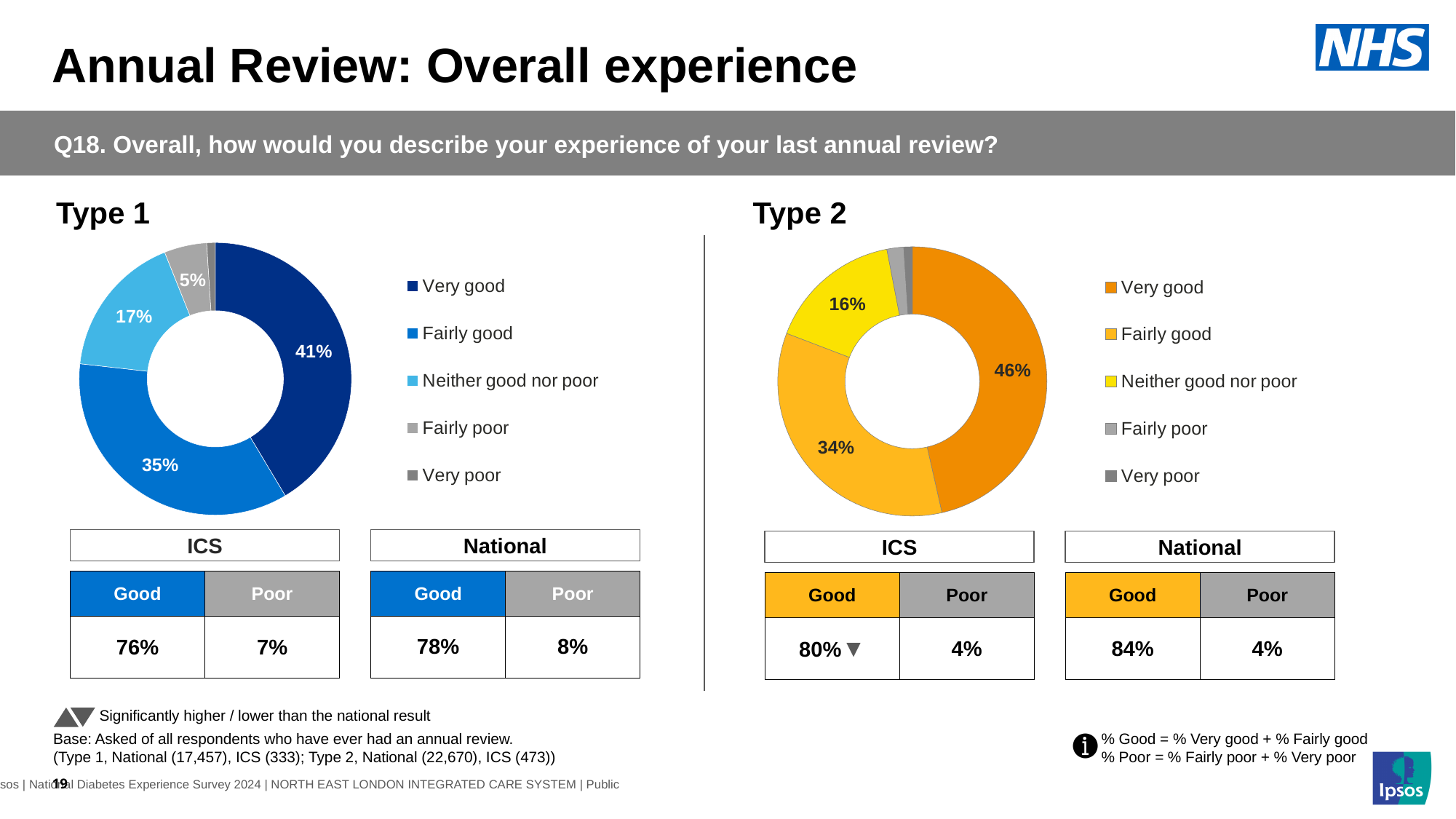
In the Type 1 chart, what percentage of respondents said 'Fairly good'? 35% How many response categories does the legend of the Type 2 chart list? 5 In the Type 1 chart, what is the difference between the 'Very good' and 'Fairly good' shares? 6 percentage points In the Type 2 chart, what percentage of respondents said 'Very good'? 46% In the Type 1 chart, which response category has the largest share? Very good In the Type 1 chart, what percentage of respondents said their experience was 'Very good'? 41% In the Type 2 chart, what percentage of respondents said 'Neither good nor poor'? 16% In the Type 2 chart, what percentage of respondents said 'Fairly good'? 34% Which chart has the larger 'Very good' share, Type 1 or Type 2? Type 2 In the Type 2 chart, which response category has the largest share? Very good What kind of chart is used to show the Type 1 results? Doughnut chart In the Type 1 chart, what percentage of respondents said 'Neither good nor poor'? 17%